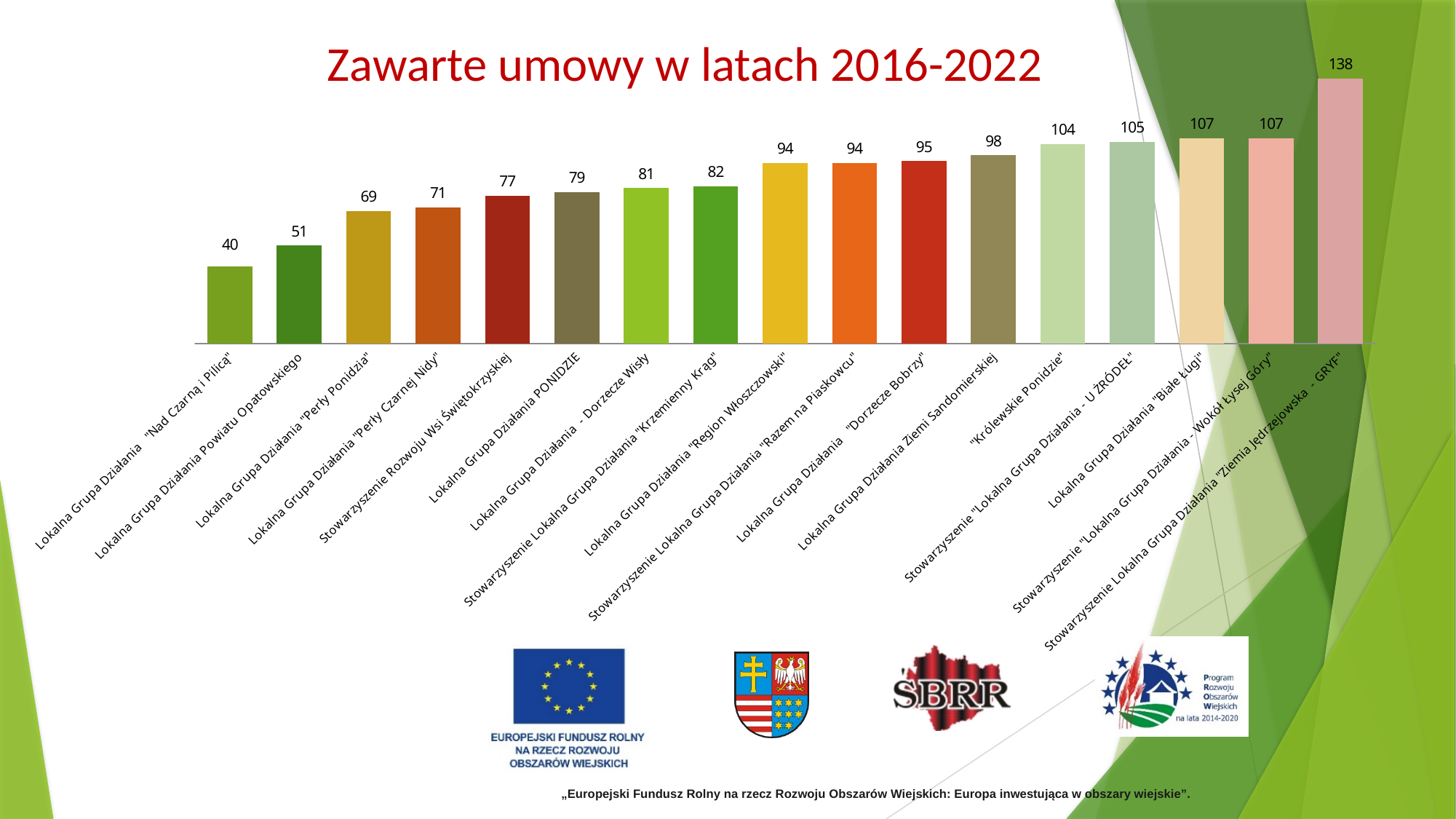
What is the difference between the values for Lokalna Grupa Działania Powiatu Opatowskiego and Lokalna Grupa Działania "Nad Czarną i Pilicą"? 11 What is the title of the chart? Zawarte umowy w latach 2016-2022 Which category has the highest value? Stowarzyszenie Lokalna Grupa Działania "Ziemia Jędrzejowska - GRYF" What is the value for Stowarzyszenie Rozwoju Wsi Świętokrzyskiej? 77 What kind of chart is shown on the slide? Bar chart What is the value for Lokalna Grupa Działania Ziemi Sandomierskiej? 98 How many categories are shown in the chart? 17 Which is larger: the value for Lokalna Grupa Działania "Perły Ponidzia" or the value for Lokalna Grupa Działania PONIDZIE? Lokalna Grupa Działania PONIDZIE What is the value for Lokalna Grupa Działania "Nad Czarną i Pilicą"? 40 What is the value for "Królewskie Ponidzie"? 104 Which category has the lowest value? Lokalna Grupa Działania "Nad Czarną i Pilicą" What is the difference between the values for Stowarzyszenie Lokalna Grupa Działania "Ziemia Jędrzejowska - GRYF" and Lokalna Grupa Działania "Białe Ługi"? 31